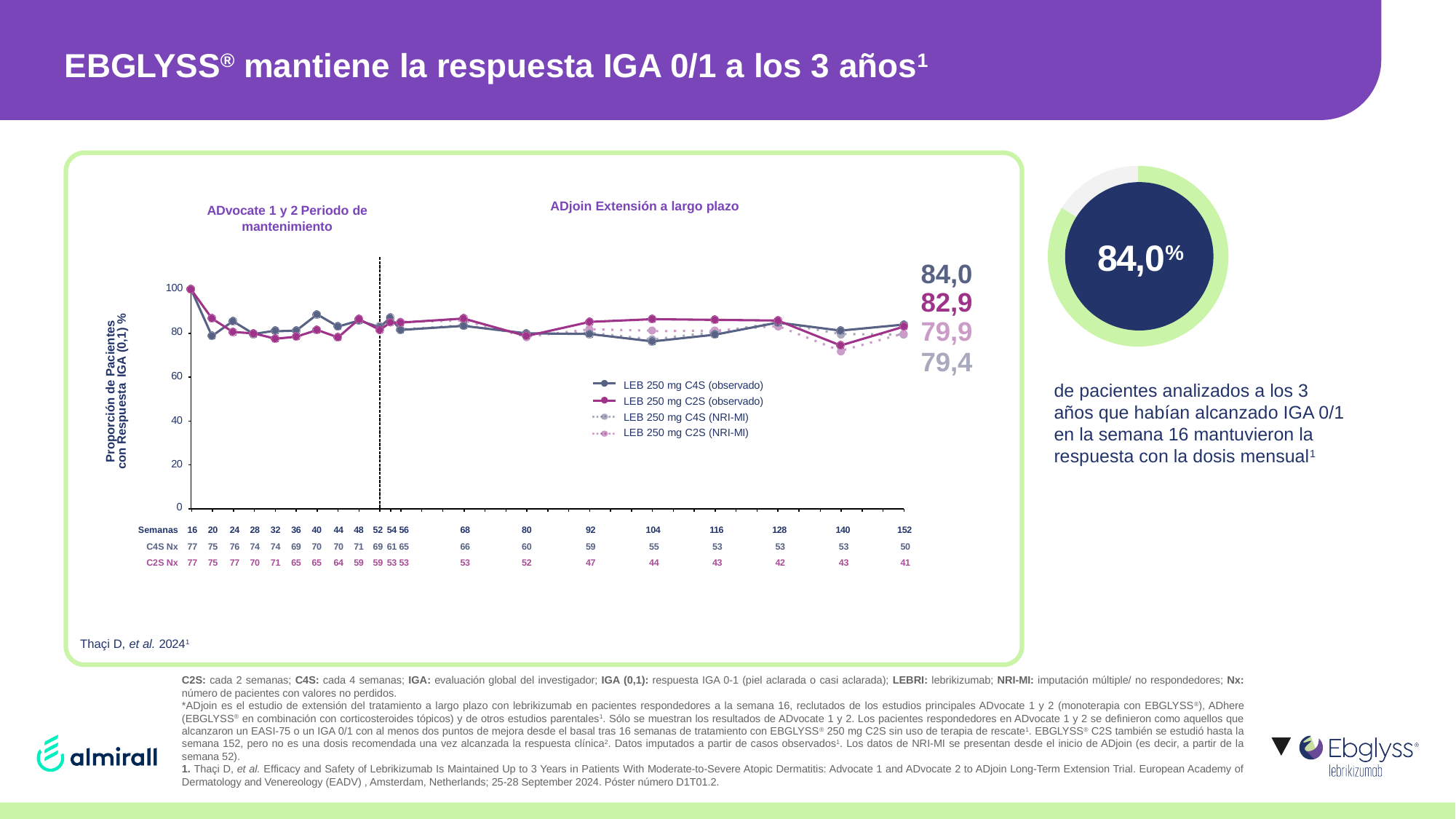
What kind of chart is the main chart on the left of the slide? Line chart What is the label of the y axis on the line chart? Proporción de Pacientes con Respuesta IGA (0,1) % What percentage is shown in the donut chart on the right? 84,0% What kind of chart is shown on the right of the slide with the 84,0% value? Donut (pie) chart On the line chart, which series has the highest value at week 152? LEB 250 mg C4S (observado) On the line chart, what is the lowest value printed at week 152? 79,4 On the line chart, is the value for LEB 250 mg C4S (observado) at week 40 greater or less than 80? greater On the line chart, how many week time points are labelled on the x axis? 20 On the line chart, how many series does the legend list? 4 On the line chart, what is the difference between the two observed values at week 152 (84,0 and 82,9)? 1,1 On the line chart, what is the value printed for LEB 250 mg C4S (observado) at week 152? 84,0 On the line chart, what is the value printed for LEB 250 mg C2S (observado) at week 152? 82,9